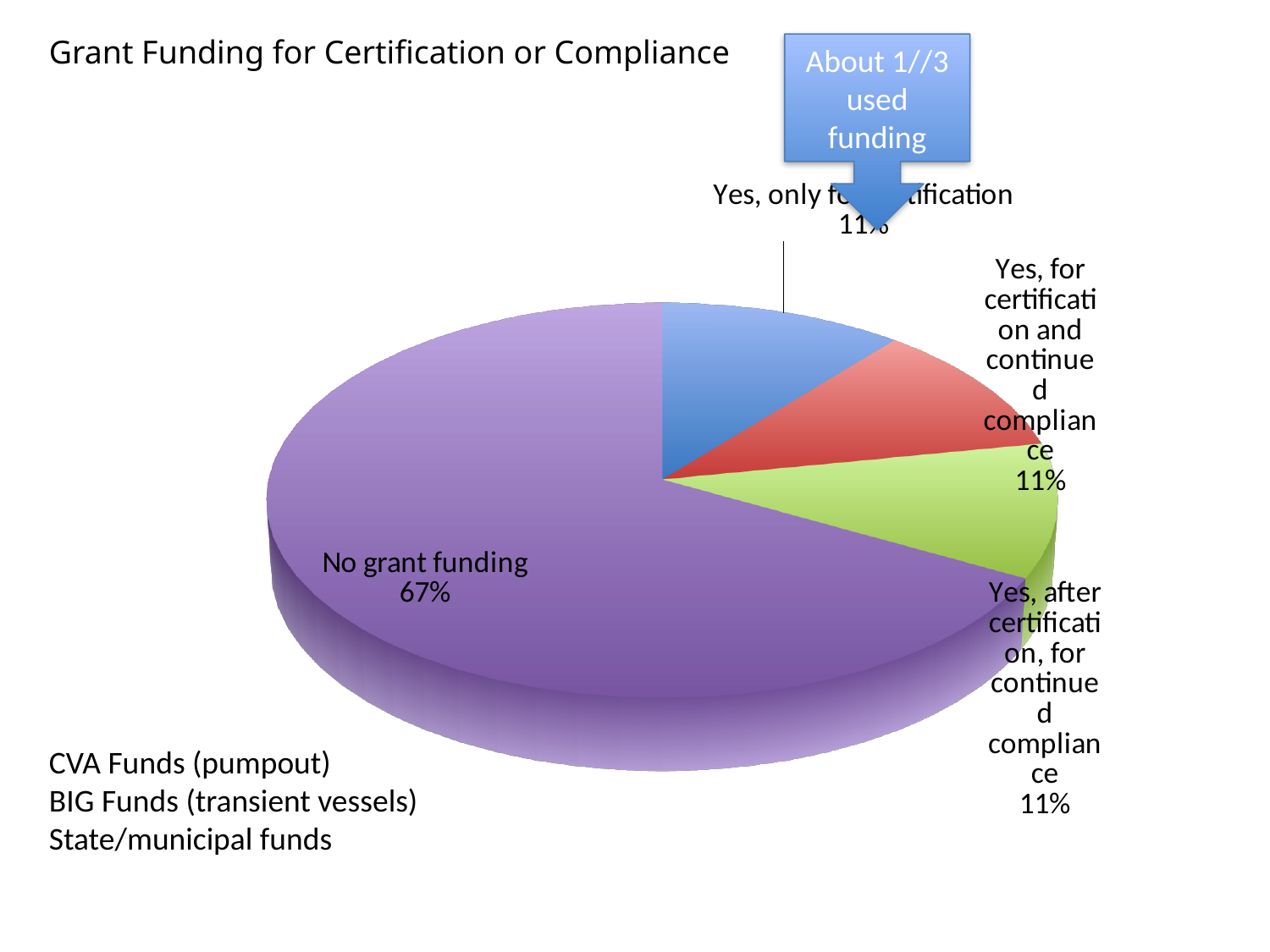
Which is larger: "No grant funding" or "Yes, for certification and continued compliance"? No grant funding Which slice of the pie is the largest? No grant funding What percentage of the pie is labelled "No grant funding"? 67% What colour is the "No grant funding" slice? purple What is the title of the chart? Grant Funding for Certification or Compliance What is the value shown for "Yes, for certification and continued compliance"? 11% What kind of chart is shown on the slide? pie chart How many slices does the pie chart have? 4 What is the difference between the "No grant funding" slice and the "Yes, after certification, for continued compliance" slice? 56% What is the value shown for "Yes, after certification, for continued compliance"? 11% What share of the pie does "No grant funding" represent? 67%